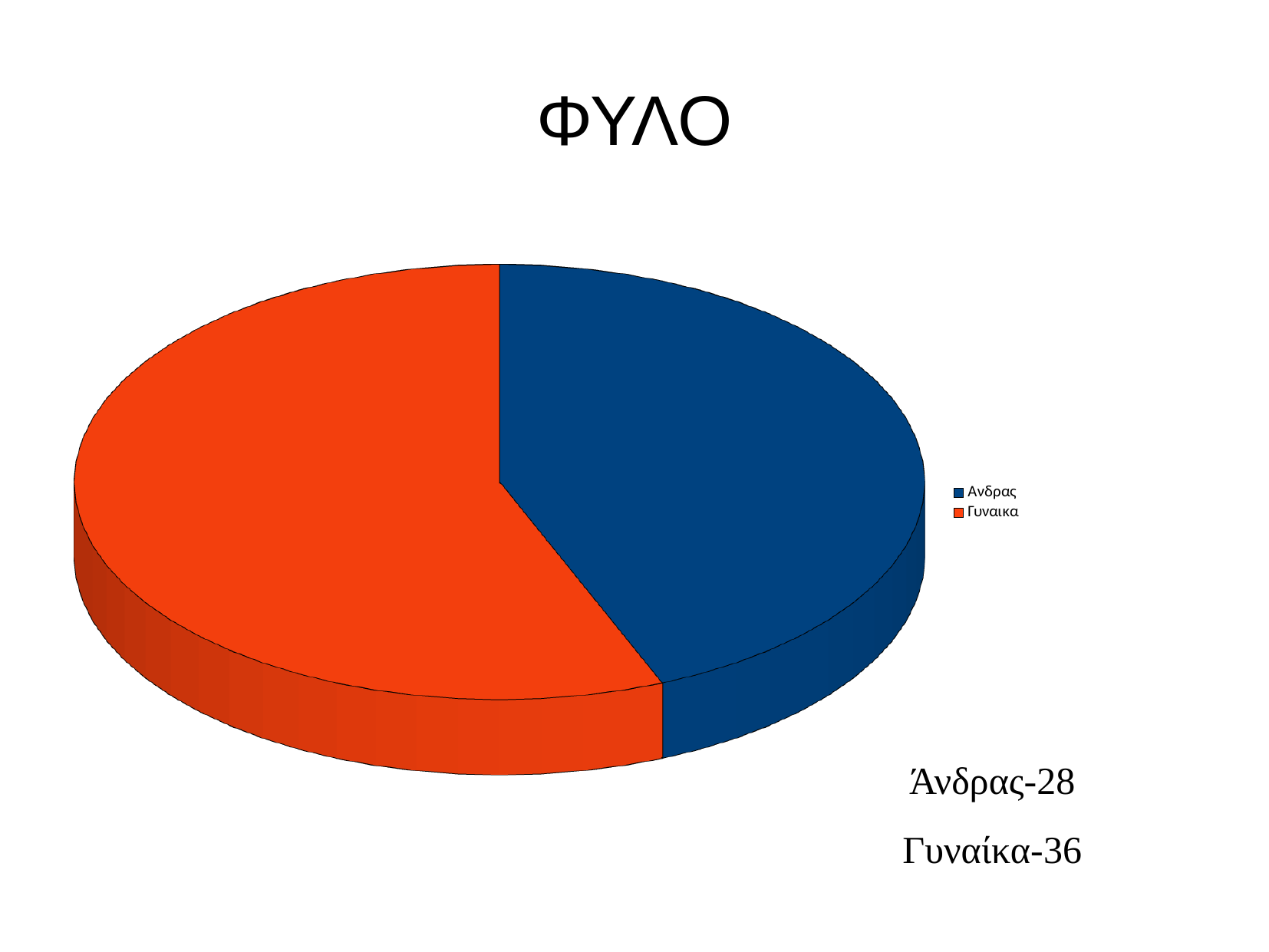
How many entries does the legend list? 2 What is the difference between the value for Γυναίκα and the value for Άνδρας? 8 What is the total of the two values shown for the pie chart? 64 What is the value for Γυναίκα? 36 What kind of chart is shown on the slide? pie chart What is the title of the chart? ΦΥΛΟ What is the value for Άνδρας? 28 Which category has the smallest slice of the pie? Άνδρας Which category has the largest slice of the pie? Γυναίκα How many slices does the pie chart have? 2 Which colour represents Άνδρας in the pie chart? blue Which is larger, the value for Άνδρας or the value for Γυναίκα? Γυναίκα